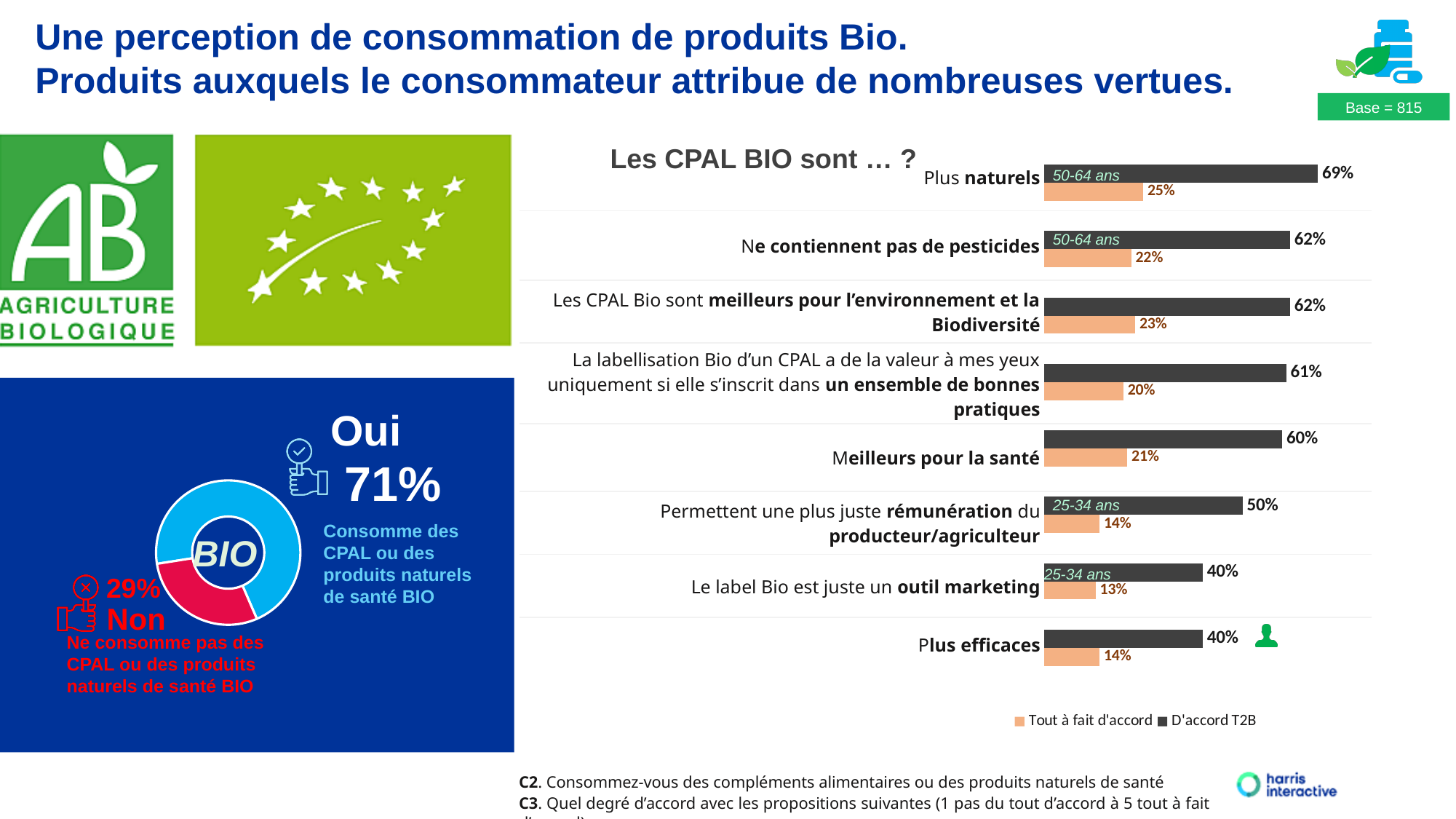
In the bar chart 'Les CPAL BIO sont … ?', what is the difference between the 'D'accord T2B' values for 'Plus naturels' and 'Plus efficaces'? 29 percentage points How many series does the legend of the bar chart 'Les CPAL BIO sont … ?' list? 2 In the bar chart 'Les CPAL BIO sont … ?', which statement has the highest 'D'accord T2B' value? Plus naturels What kind of chart is 'Les CPAL BIO sont … ?'? Bar chart In the bar chart 'Les CPAL BIO sont … ?', which colour represents the 'Tout à fait d'accord' series? Orange In the bar chart 'Les CPAL BIO sont … ?', what is the 'Tout à fait d'accord' value for 'Meilleurs pour la santé'? 21% How many statements (categories) are shown in the bar chart 'Les CPAL BIO sont … ?'? 8 In the bar chart 'Les CPAL BIO sont … ?', what is the 'D'accord T2B' value for 'Plus naturels'? 69% In the bar chart 'Les CPAL BIO sont … ?', what is the lowest 'Tout à fait d'accord' value shown? 13% In the donut chart on the left, what is the value for 'Non'? 29% In the bar chart 'Les CPAL BIO sont … ?', which has a higher 'D'accord T2B' value: 'Meilleurs pour la santé' or 'Le label Bio est juste un outil marketing'? Meilleurs pour la santé In the donut chart on the left, what share of respondents answered 'Oui'? 71%